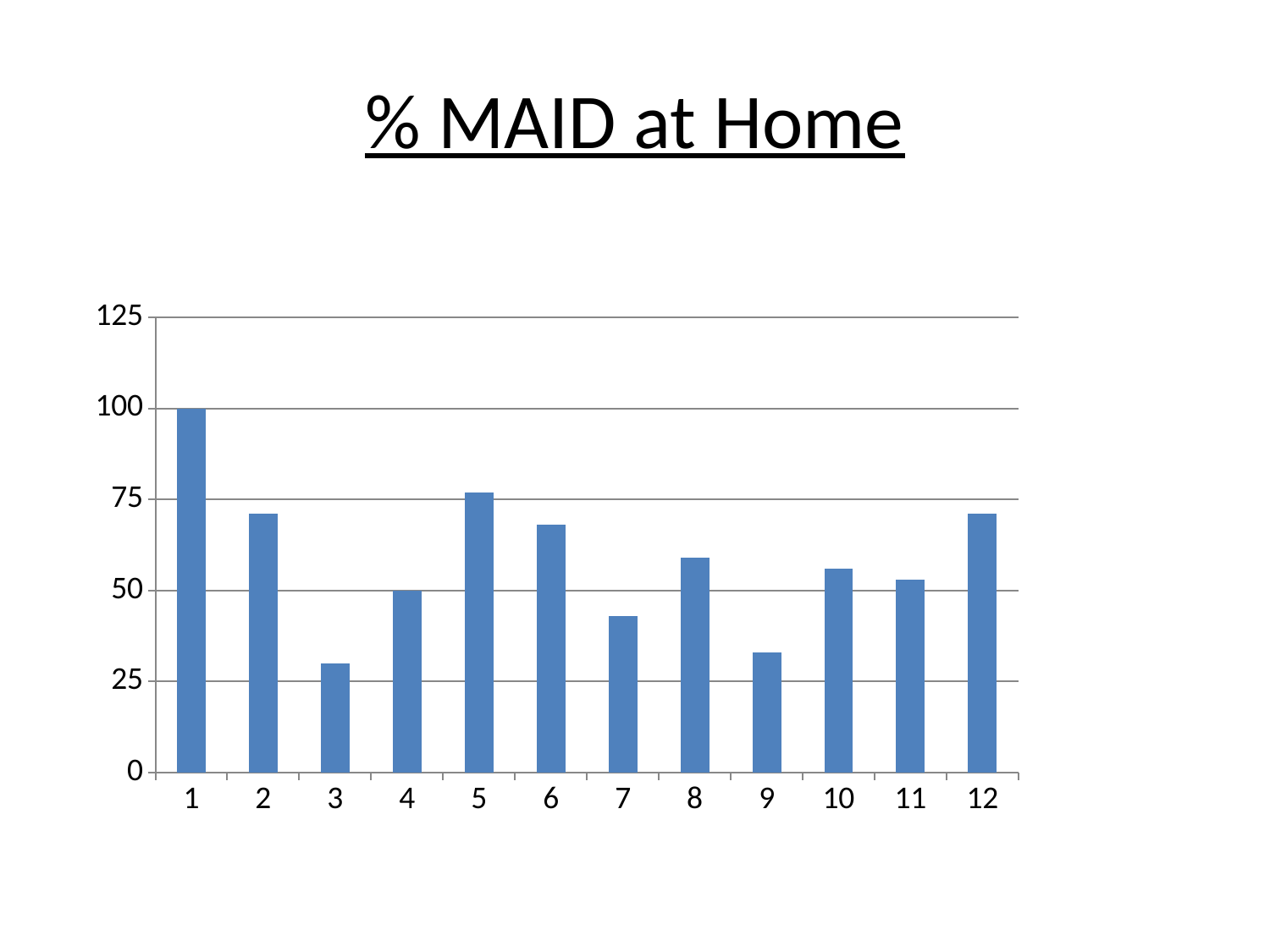
How many bars are plotted in the chart? 12 What is the title of the chart? % MAID at Home Which is larger, the value for category 2 or the value for category 3? 2 What kind of chart is shown on the slide? bar chart What is the value for category 1? 100 Which is larger, the value for category 8 or the value for category 9? 8 What is the value for category 4? 50 Which category has the lowest value? 3 Is the value for category 7 greater or less than 50? less Is the value for category 9 greater or less than 50? less Which category has the highest value? 1